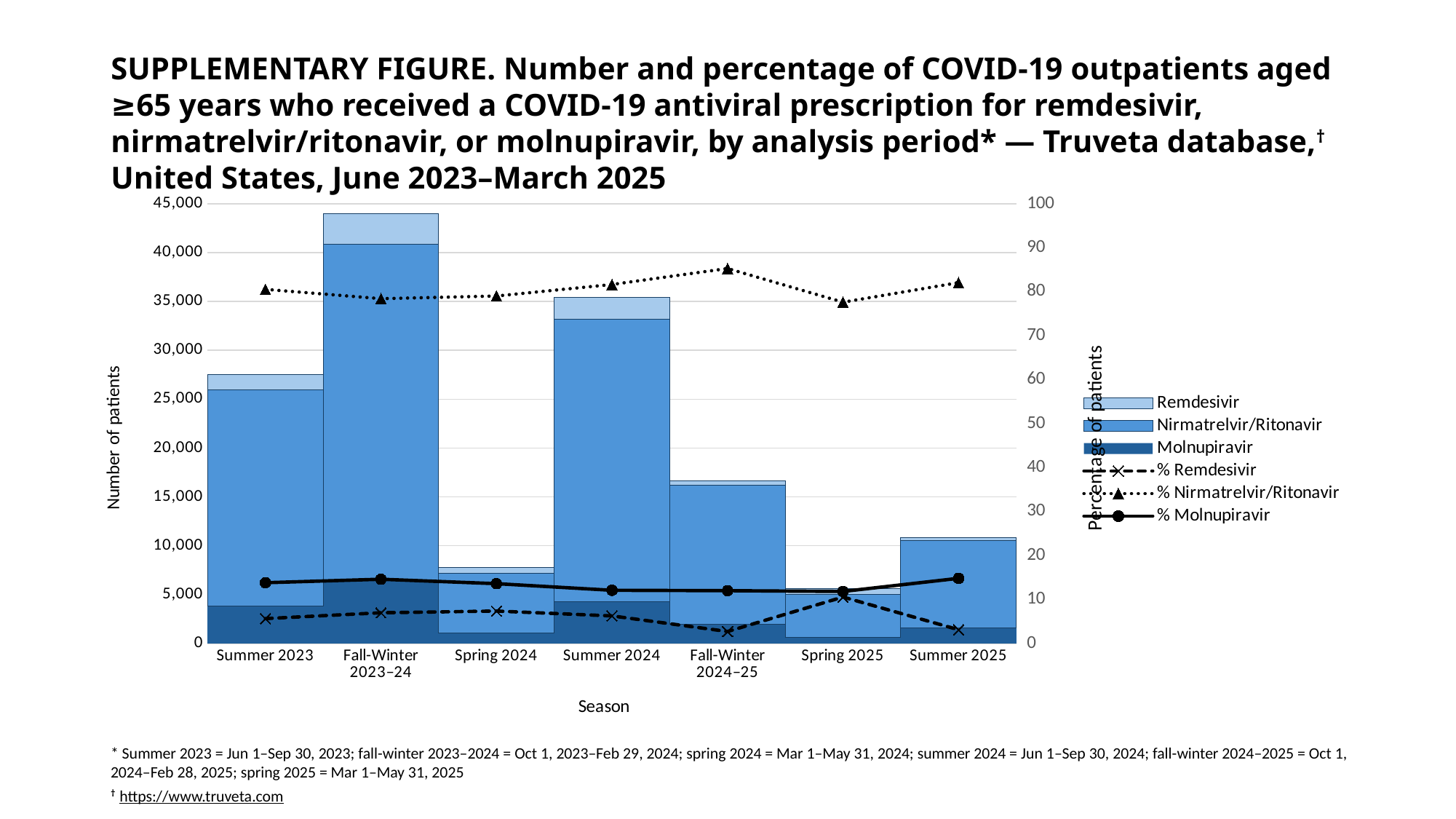
In which season is the % Remdesivir line at its highest? Spring 2025 What is the title of the x axis? Season Is the % Nirmatrelvir/Ritonavir value for Spring 2025 greater or less than 70? greater What kind of chart is shown on the slide? Combination bar and line chart How many series does the legend list? 6 How many seasons are shown on the x axis? 7 Is the total number of patients for Fall-Winter 2023–24 greater or less than 40,000? greater In which season is the % Nirmatrelvir/Ritonavir line at its highest? Fall-Winter 2024–25 In Summer 2023, which is larger: % Molnupiravir or % Remdesivir? % Molnupiravir Which season has the highest total number of patients? Fall-Winter 2023–24 Is the total number of patients for Fall-Winter 2024–25 greater or less than 20,000? less Which season has the lowest total number of patients? Spring 2025